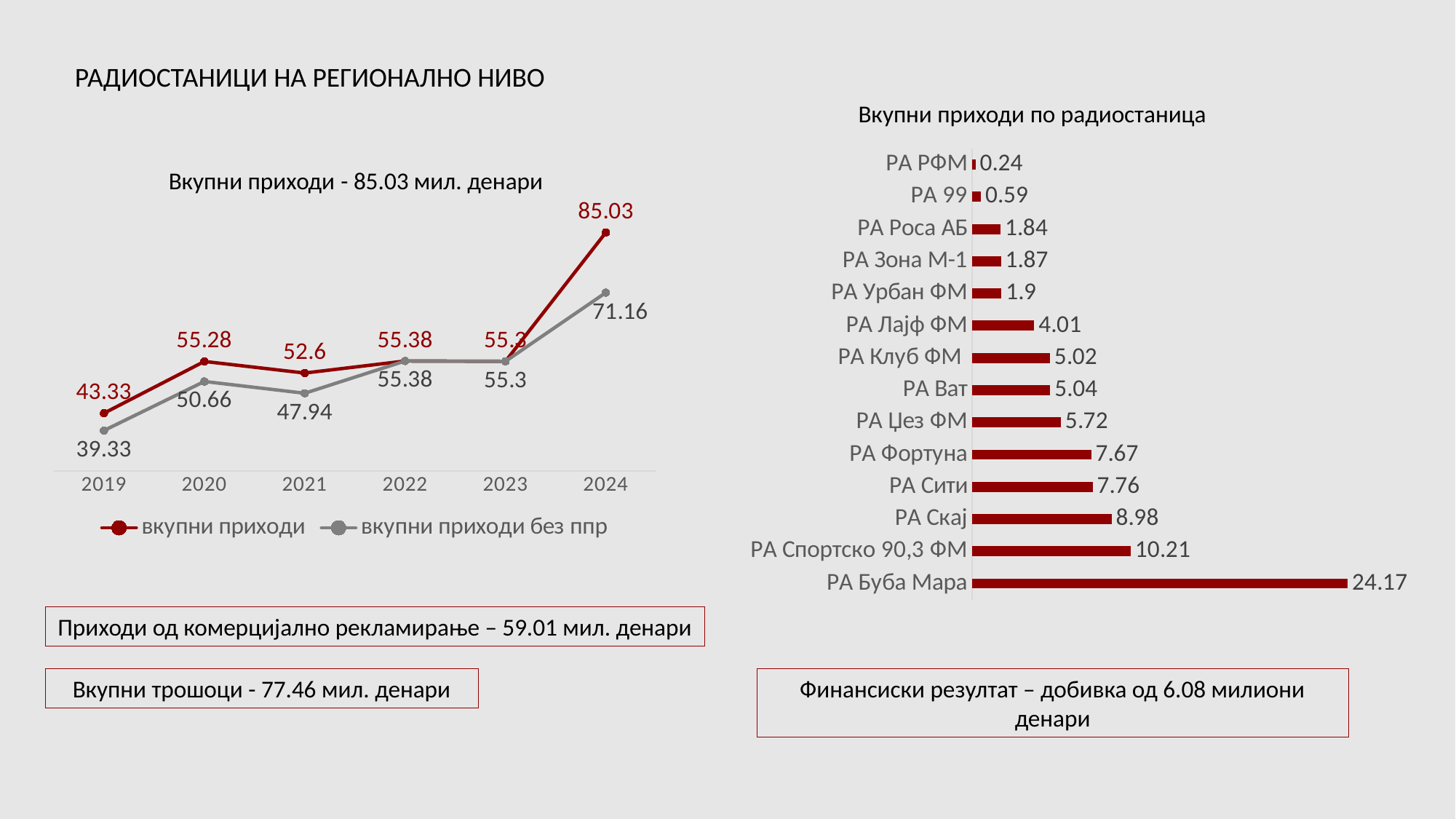
In the chart titled 'Вкупни приходи по радиостаница', which radio station has the lowest value? РА РФМ In the chart titled 'Вкупни приходи - 85.03 мил. денари', what is the value of 'вкупни приходи без ппр' for 2019? 39.33 In the chart titled 'Вкупни приходи - 85.03 мил. денари', what kind of chart is it? line chart In the chart titled 'Вкупни приходи - 85.03 мил. денари', how many years are shown on the x axis? 6 In the chart titled 'Вкупни приходи - 85.03 мил. денари', which year has the lowest value for 'вкупни приходи'? 2019 In the chart titled 'Вкупни приходи по радиостаница', what is the value for 'РА Спортско 90,3 ФМ'? 10.21 In the chart titled 'Вкупни приходи по радиостаница', how many radio stations are listed? 14 In the chart titled 'Вкупни приходи по радиостаница', what is the difference between 'РА Буба Мара' and 'РА Скај'? 15.19 In the chart titled 'Вкупни приходи - 85.03 мил. денари', what is the difference between 'вкупни приходи' and 'вкупни приходи без ппр' in 2021? 4.66 In the chart titled 'Вкупни приходи - 85.03 мил. денари', what is the value of 'вкупни приходи' for 2024? 85.03 In the chart titled 'Вкупни приходи - 85.03 мил. денари', how many series does the legend list? 2 In the chart titled 'Вкупни приходи по радиостаница', which radio station has the highest value? РА Буба Мара